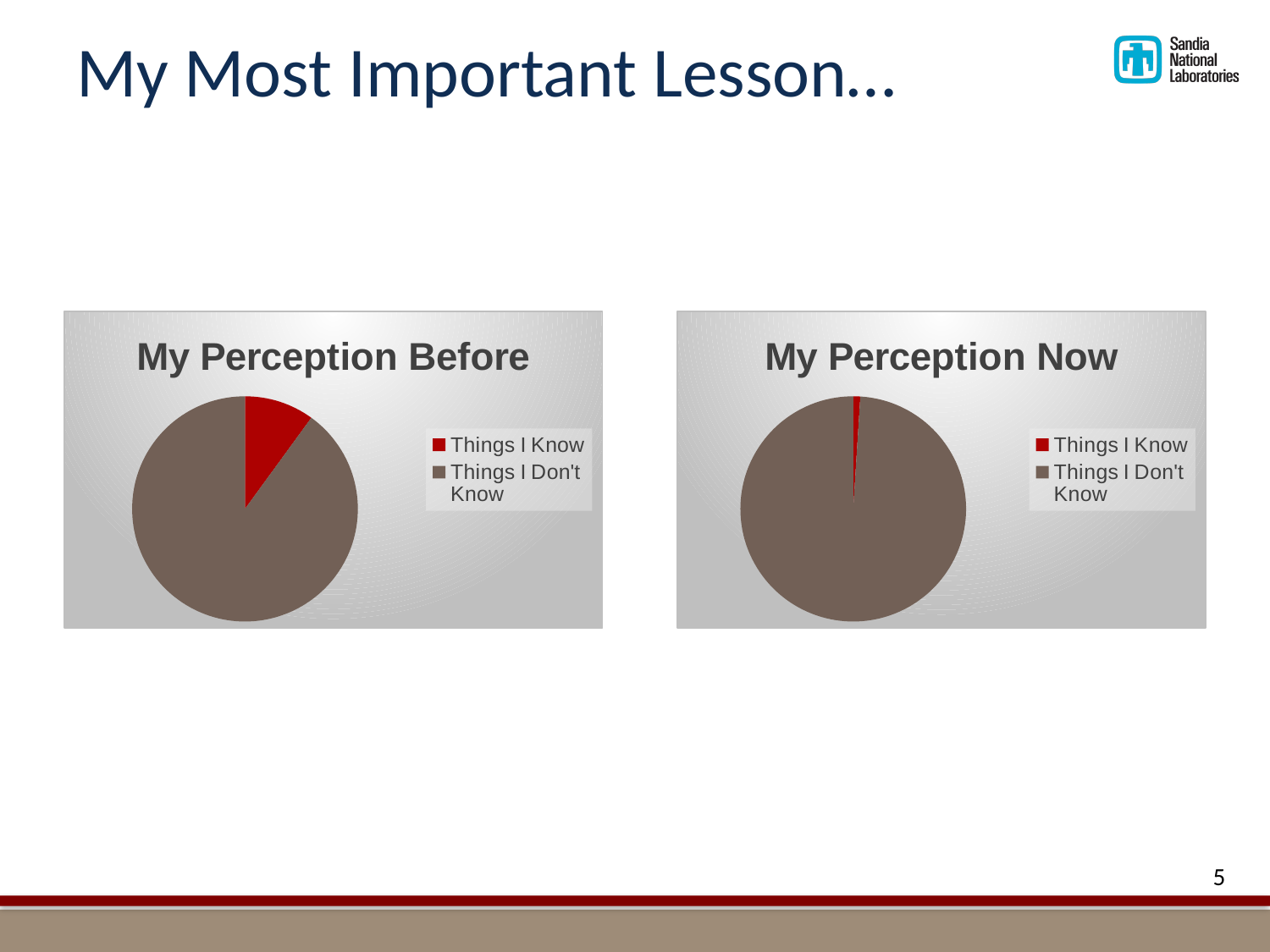
In the "My Perception Now" chart, which is larger: the slice for "Things I Know" or the slice for "Things I Don't Know"? Things I Don't Know In the "My Perception Now" chart, which category has the largest slice? Things I Don't Know Comparing the two charts, is the "Things I Know" slice larger in "My Perception Before" or in "My Perception Now"? My Perception Before In the "My Perception Before" chart, what colour is the "Things I Know" slice? red What kind of chart is "My Perception Before"? pie chart In the "My Perception Before" chart, which category has the largest slice? Things I Don't Know In the "My Perception Now" chart, how many categories does the legend list? 2 In the "My Perception Now" chart, which category has the smallest slice? Things I Know In the "My Perception Before" chart, how many slices does the pie have? 2 In the "My Perception Before" chart, which category has the smallest slice? Things I Know What kind of chart is "My Perception Now"? pie chart What is the title of the chart on the right side of the slide? My Perception Now